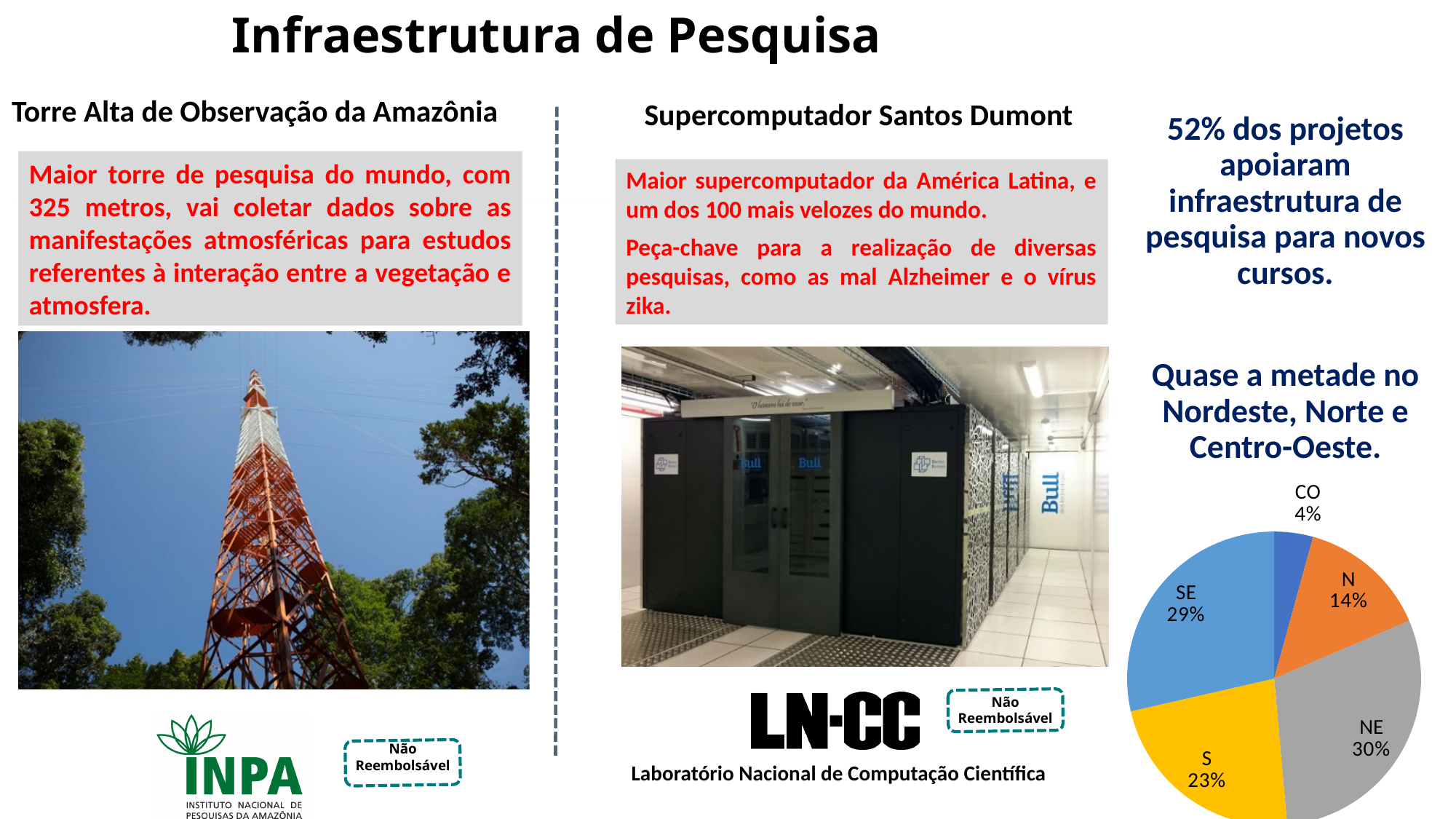
What share of the pie does NE have? 30% What share of the pie does SE have? 29% What share of the pie does N have? 14% Which is larger, the share for N or the share for S? S What is the combined share of NE, N and CO? 48% Which region has the smallest slice of the pie? CO What kind of chart is shown on the slide? pie chart Which region has the largest slice of the pie? NE How many regions are shown in the pie chart? 5 What share of the pie does CO have? 4% What share of the pie does S have? 23% What is the difference between the shares of NE and S? 7%